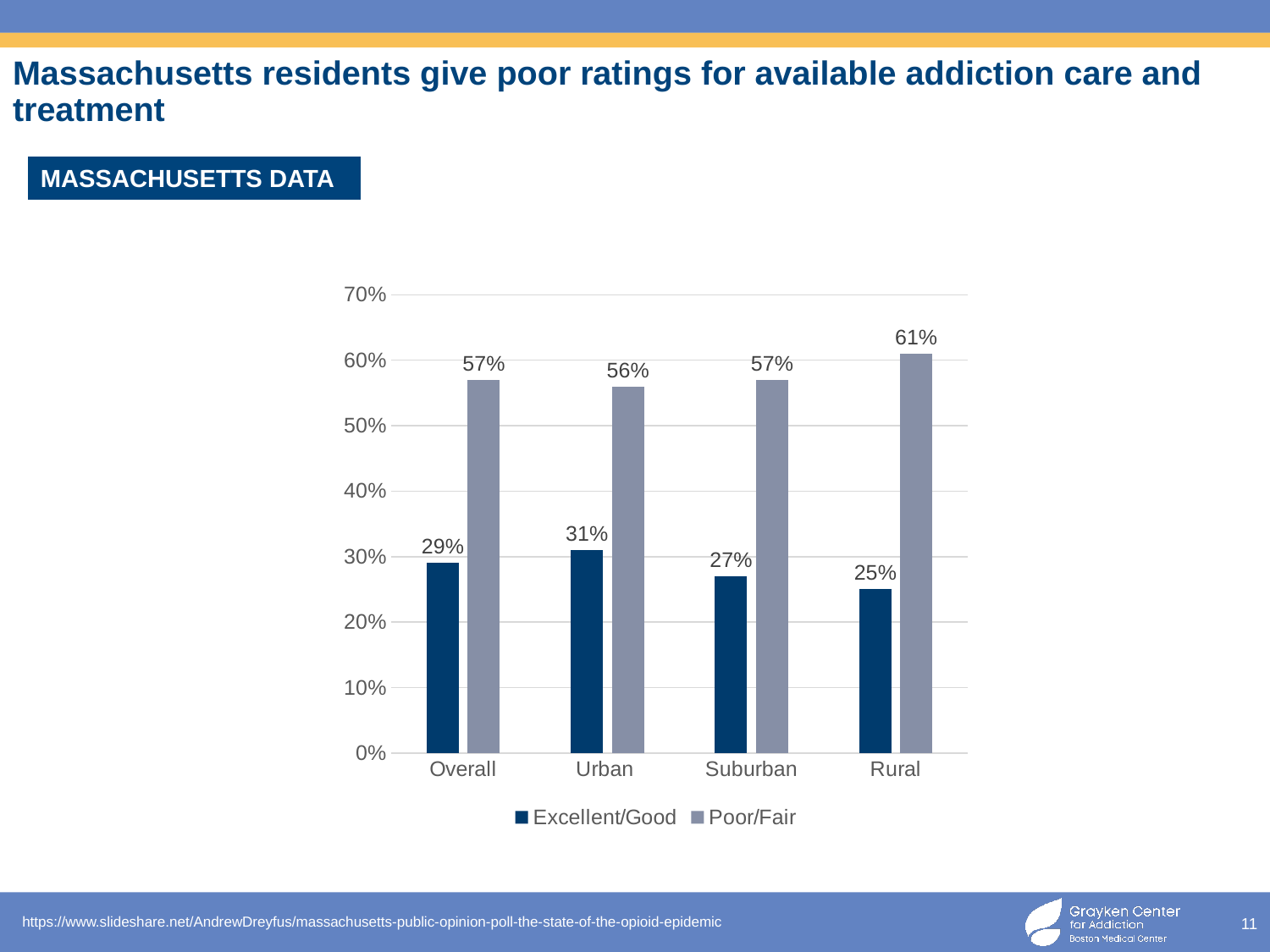
How many series does the legend list? 2 Is the Poor/Fair value for Urban greater or less than 50%? greater What is the Poor/Fair value for Rural? 61% What kind of chart is shown on the slide? Bar chart What is the Excellent/Good value for Urban? 31% How many categories are shown on the x axis? 4 What is the difference between the Poor/Fair and Excellent/Good values for Suburban? 30% Which is larger, the Excellent/Good value for Urban or for Suburban? Urban What are the two series named in the legend? Excellent/Good and Poor/Fair Which category has the lowest Excellent/Good value? Rural Which category has the highest Poor/Fair value? Rural What is the Excellent/Good value for Overall? 29%